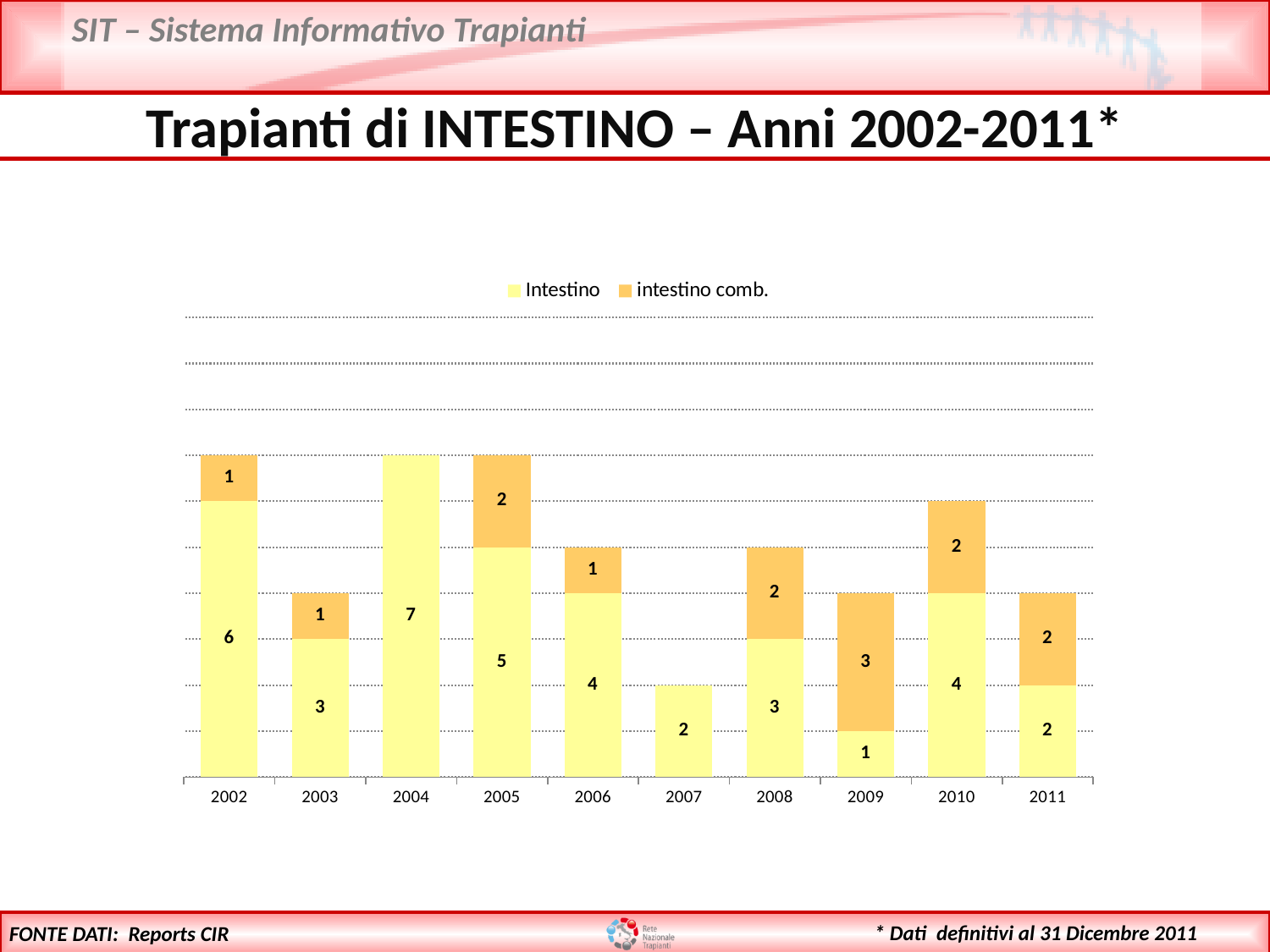
What is the difference between the Intestino values for 2005 and 2008? 2 How many series does the legend list? 2 How many years are shown on the x axis? 10 Which is larger, the Intestino value for 2006 or for 2011? 2006 Which year has the lowest Intestino value? 2009 What type of chart is shown on the slide? stacked bar chart What is the intestino comb. value for 2009? 3 Which year has the highest Intestino value? 2004 What is the Intestino value for 2007? 2 What is the total of the stacked bar for 2010? 6 What is the Intestino value for 2002? 6 Which year has the highest intestino comb. value? 2009